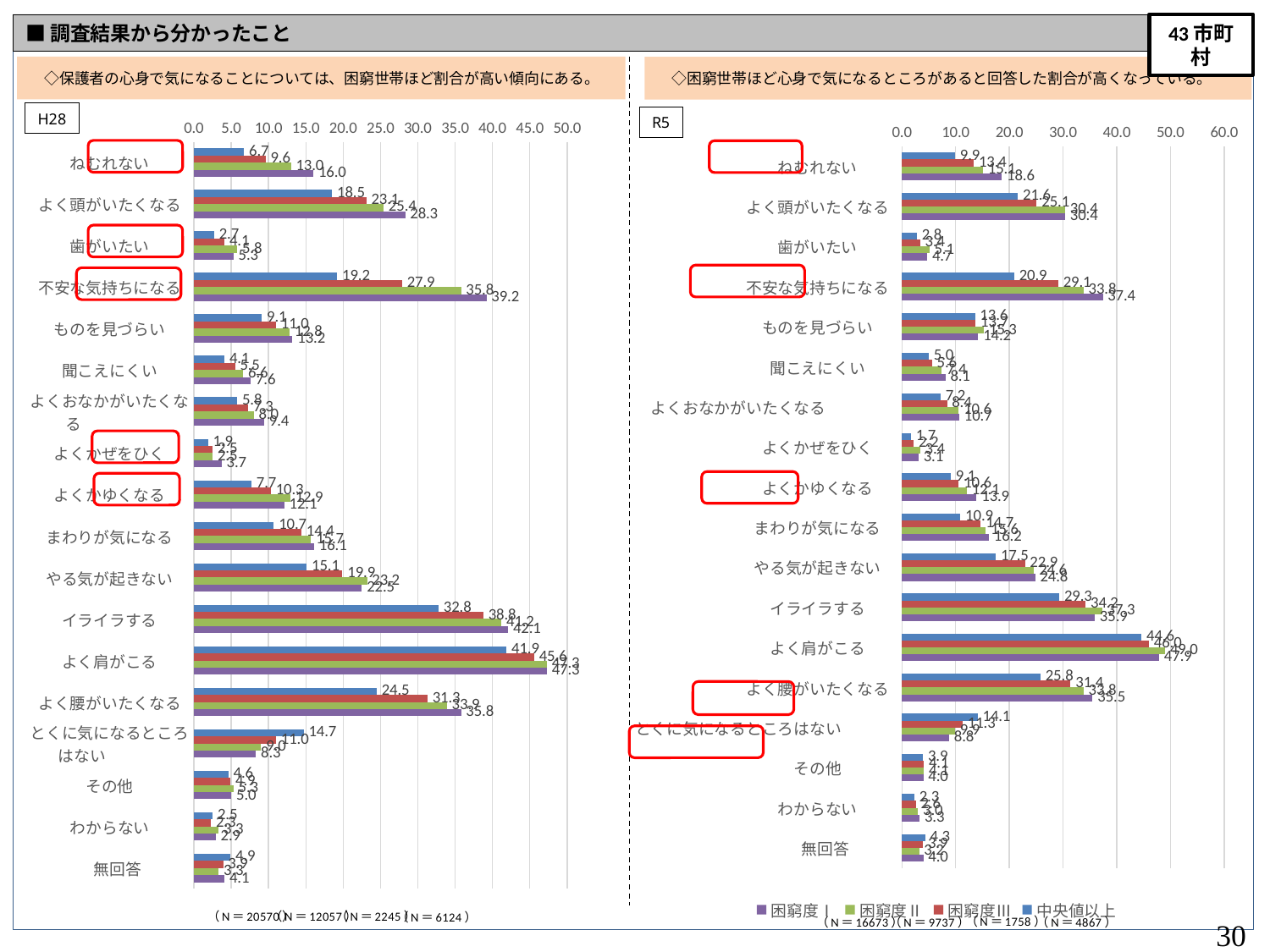
How many categories are plotted on the R5 chart on the right? 18 In the R5 chart, what is the difference between the 困窮度Ⅰ value and the 中央値以上 value for 不安な気持ちになる? 16.5 In the H28 chart, what is the value for 困窮度Ⅰ for 不安な気持ちになる? 39.2 In the H28 chart, what is the value for 中央値以上 for イライラする? 32.8 In the H28 chart, which category has the lowest value for 中央値以上? よくかぜをひく In the R5 chart, is the 困窮度Ⅰ value for よく肩がこる greater or less than 40.0? greater What kind of chart is the H28 chart on the left? bar chart In the R5 chart, what is the value for 困窮度Ⅰ for ねむれない? 18.6 In the H28 chart, which is larger for よく腰がいたくなる: the 困窮度Ⅰ value or the 中央値以上 value? 困窮度Ⅰ In the R5 chart, what is the value for 中央値以上 for 不安な気持ちになる? 20.9 How many series does the legend at the bottom of the slide list? 4 In the R5 chart, which category has the highest value for 中央値以上? よく肩がこる